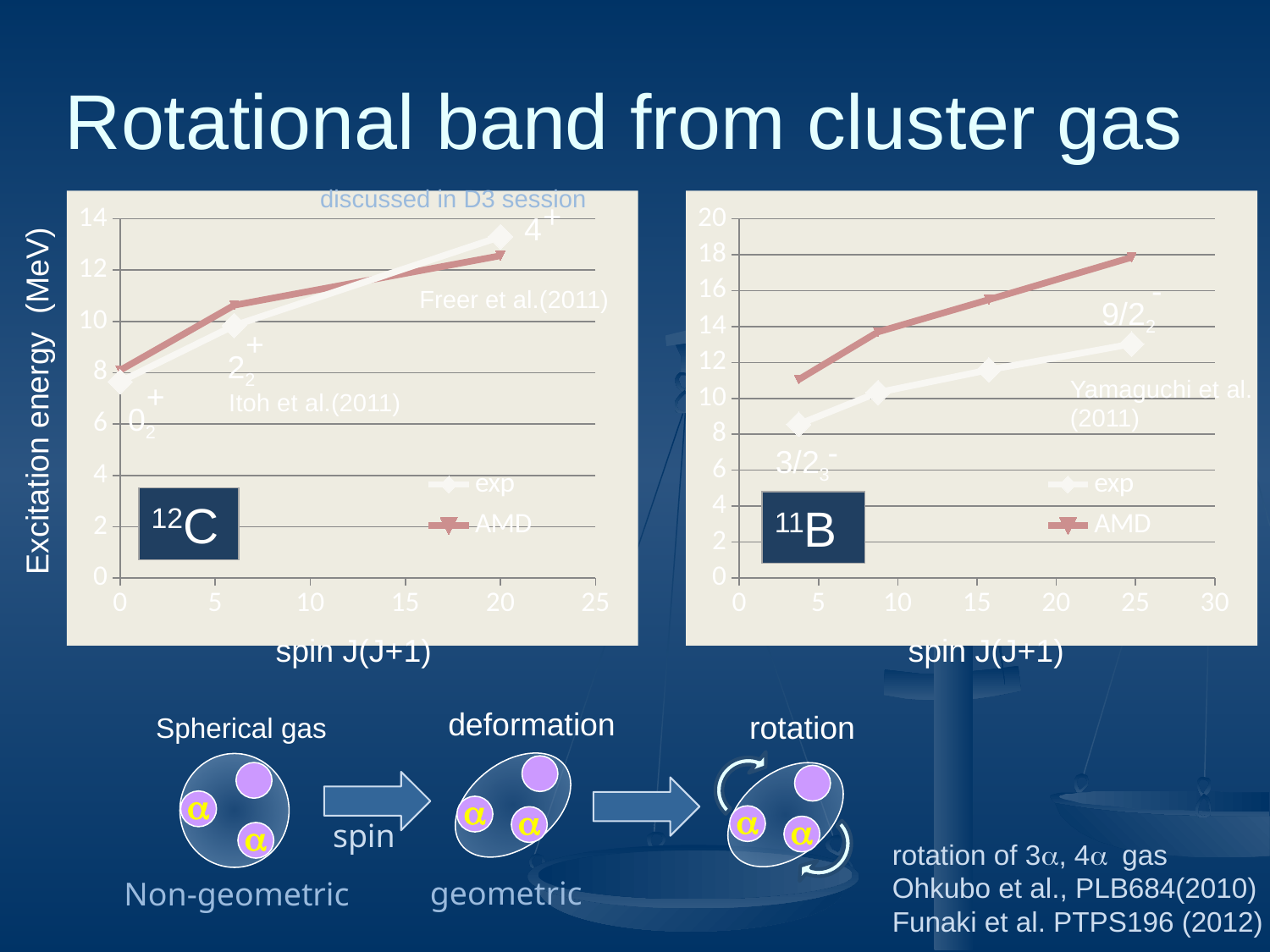
In the 11B chart on the right, at the largest spin J(J+1) value, which series is higher, exp or AMD? AMD In the 12C chart on the left, do the exp values rise or fall as spin J(J+1) increases? rise In the 11B chart on the right, is the highest AMD value greater or less than 16? greater In the 12C chart on the left, how many data points does the exp series have? 3 What kind of chart is the 12C chart on the left? line chart In the 11B chart on the right, how many data points does the exp series have? 4 In the 12C chart on the left, is the exp value at spin J(J+1) = 20 greater or less than 12? greater What are the two legend entries in the 12C chart on the left? exp and AMD What is the x-axis label of the 11B chart on the right? spin J(J+1) In the 11B chart on the right, is the lowest exp value greater or less than 10? less How many series does the legend of the 11B chart on the right list? 2